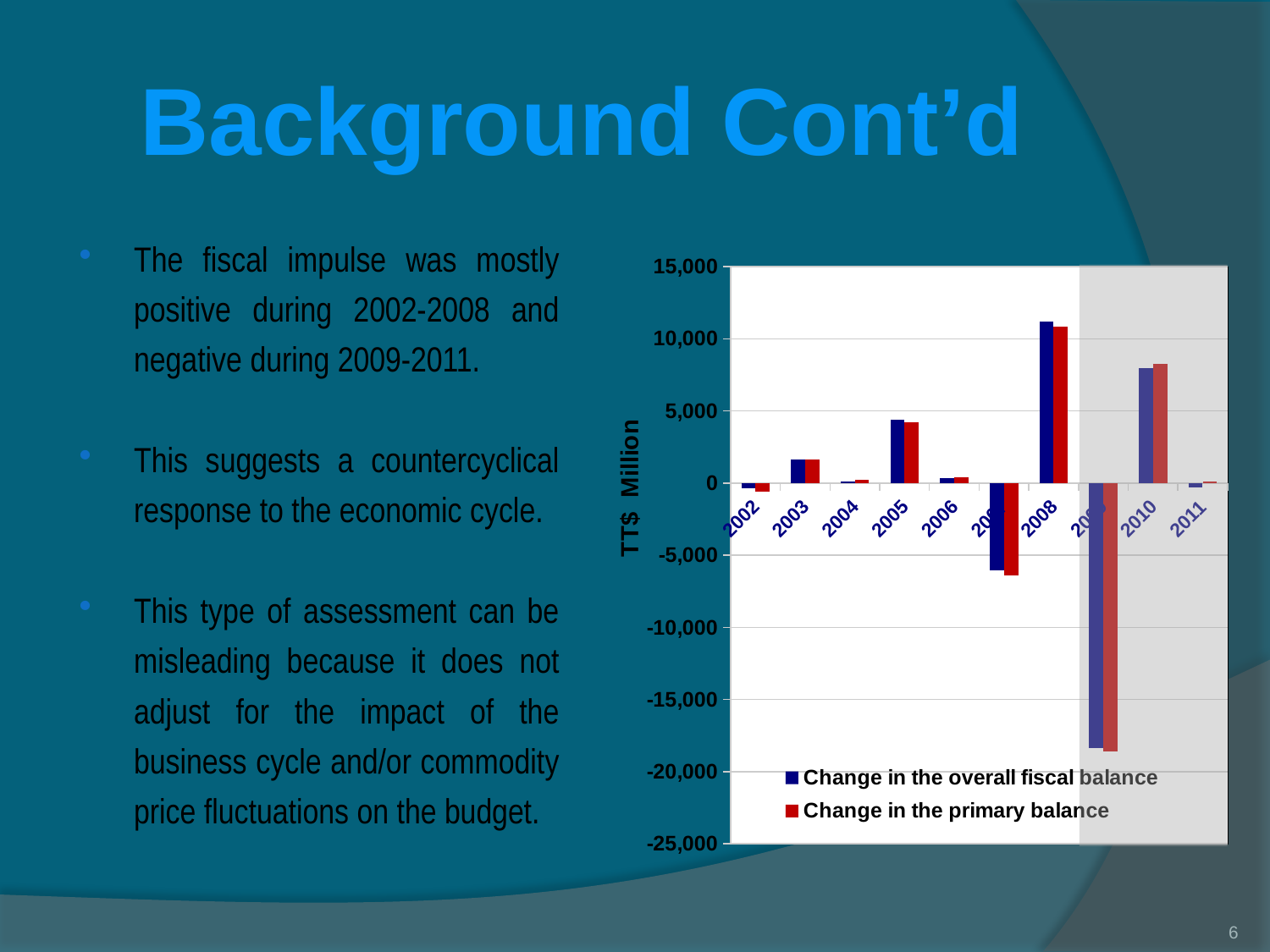
What kind of chart is shown on the slide? bar chart Is the change in the overall fiscal balance for 2008 greater or less than 10,000? greater In which year is the change in the overall fiscal balance highest? 2008 What is the label on the vertical axis of the chart? TT$ Million In which year is the change in the primary balance lowest? 2009 Is the change in the overall fiscal balance for 2005 greater or less than 5,000? less How many years are shown on the x axis of the chart? 10 Is the change in the primary balance for 2007 greater or less than -5,000? less Which year has the larger change in the primary balance, 2003 or 2005? 2005 Which year has the larger change in the overall fiscal balance, 2008 or 2010? 2008 How many series does the chart legend list? 2